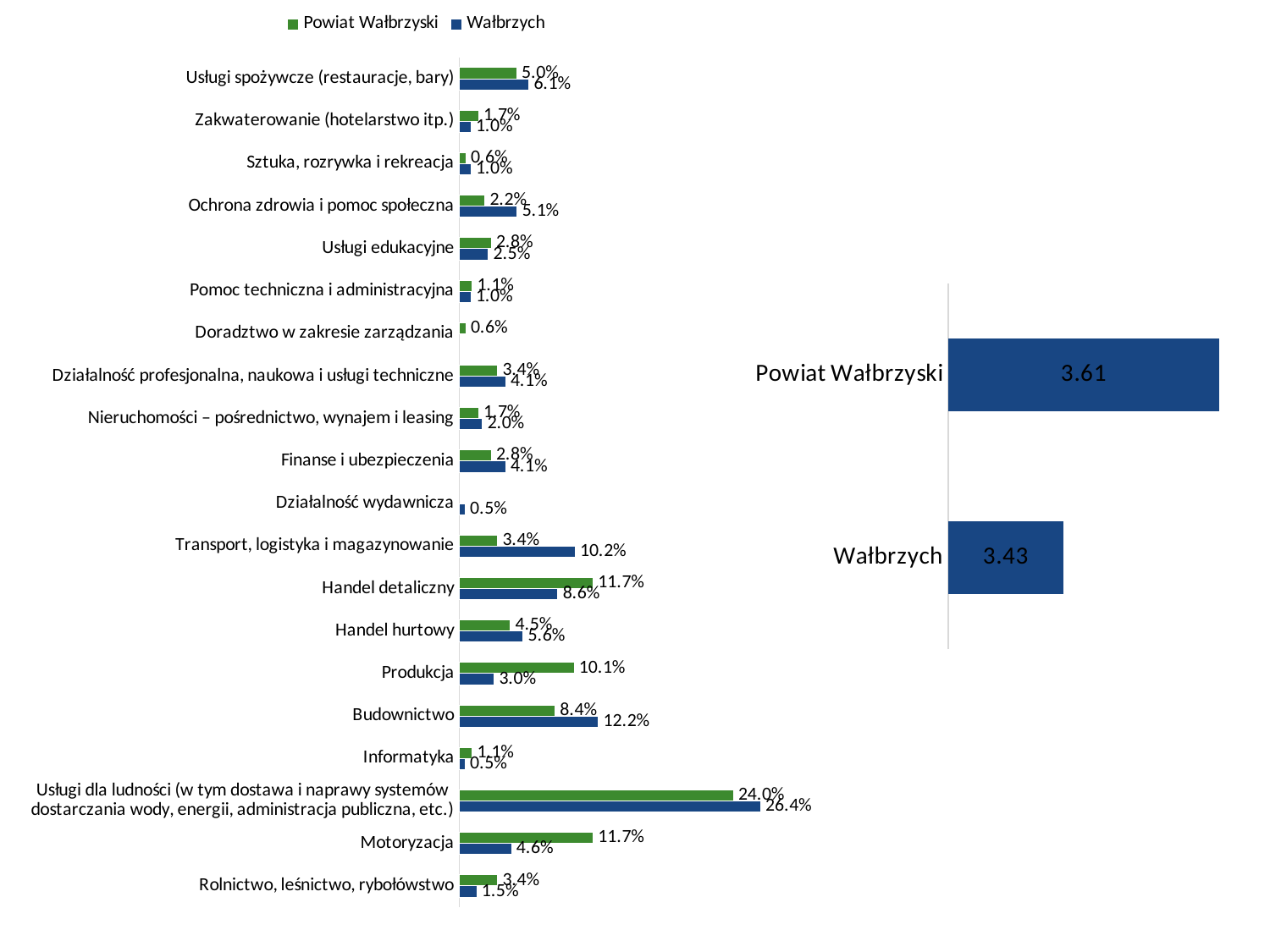
In the right bar chart, what is the value for Powiat Wałbrzyski? 3.61 How many categories are shown in the left bar chart? 20 In the left bar chart, which colour represents the Powiat Wałbrzyski series? Green In the right bar chart, what is the difference between the values for Powiat Wałbrzyski and Wałbrzych? 0.18 How many series does the legend of the left bar chart list? 2 In the left bar chart, what is the value for Powiat Wałbrzyski in the Motoryzacja category? 11.7% In the left bar chart, for Handel detaliczny, which series has the larger value: Powiat Wałbrzyski or Wałbrzych? Powiat Wałbrzyski In the left bar chart, what is the value for Wałbrzych in the Produkcja category? 3.0% In the left bar chart, what is the value for Wałbrzych in the Transport, logistyka i magazynowanie category? 10.2% In the left bar chart, which category has the highest value for the Wałbrzych series? Usługi dla ludności (w tym dostawa i naprawy systemów dostarczania wody, energii, administracja publiczna, etc.) What type of chart is the chart on the left of the slide? Bar chart In the left bar chart, what is the difference between the Wałbrzych and Powiat Wałbrzyski values for Budownictwo? 3.8 percentage points